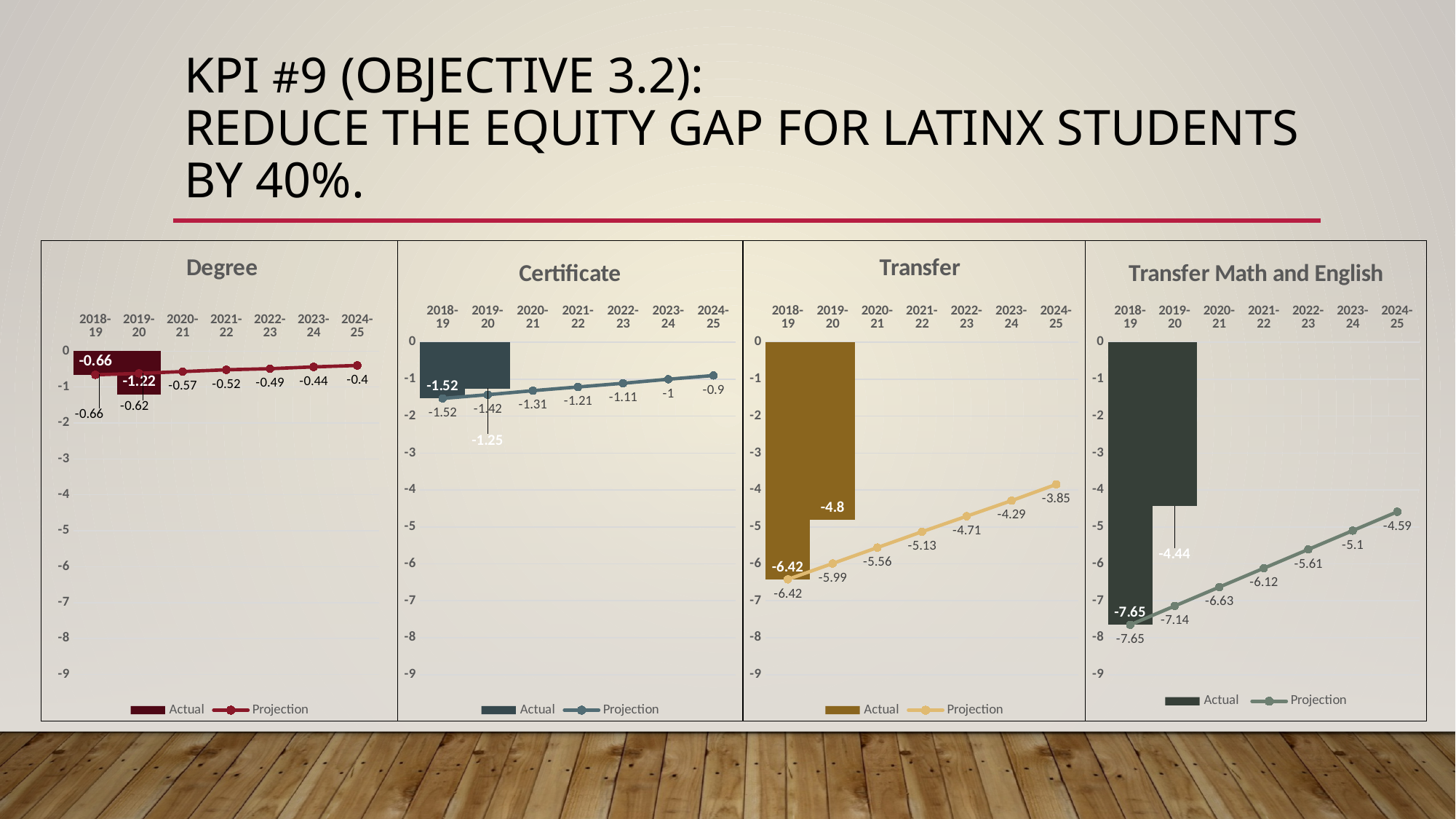
In the Certificate chart, which is larger: the Actual value for 2019-20 or the Projection value for 2019-20? Actual (-1.25) How many years are shown on the x axis of the Degree chart? 7 In the Transfer chart, what is the Actual value for 2019-20? -4.8 What are the titles of the four charts on the slide, from left to right? Degree, Certificate, Transfer, Transfer Math and English How many series does the legend of the Transfer chart list? 2 In the Degree chart, what is the Actual value for 2019-20? -1.22 In the Certificate chart, what is the Projection value for 2024-25? -0.9 In the Transfer Math and English chart, what is the Actual value for 2018-19? -7.65 In the Transfer chart, what is the difference between the Projection value for 2024-25 (-3.85) and the Projection value for 2018-19 (-6.42)? 2.57 In the Transfer Math and English chart, which year has the lowest Projection value? 2018-19 In the Transfer Math and English chart, what is the Projection value for 2021-22? -6.12 In the Transfer chart, does the Projection line rise or fall from 2018-19 to 2024-25? rise